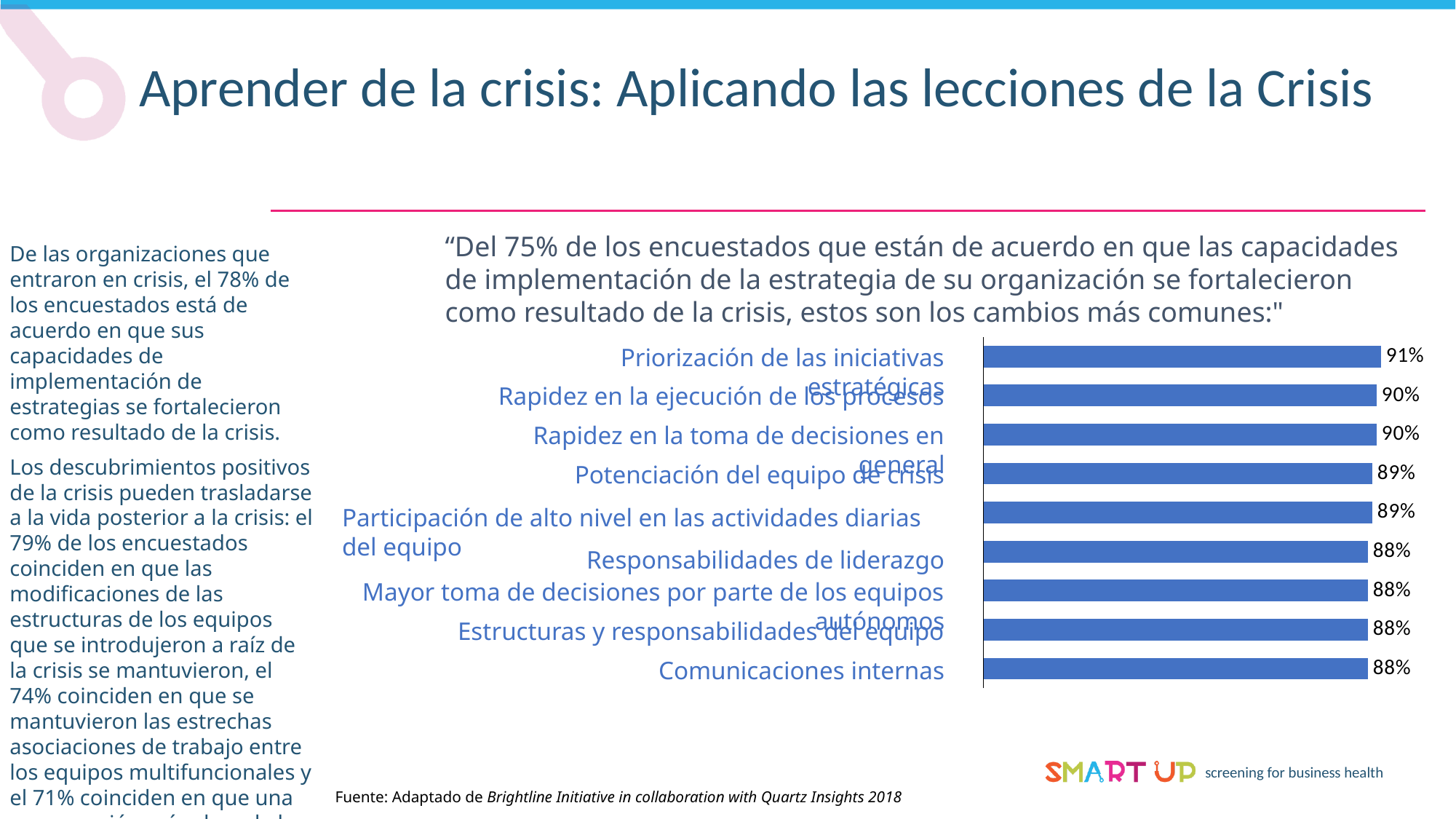
What is the difference between the value for "Priorización de las iniciativas estratégicas" and the value for "Estructuras y responsabilidades del equipo"? 3 percentage points What is the value for "Potenciación del equipo de crisis"? 89% What is the value for "Priorización de las iniciativas estratégicas"? 91% What type of chart is shown on the slide? Bar chart What is the value for "Comunicaciones internas"? 88% How many categories does the bar chart show? 9 Which is larger: the value for "Priorización de las iniciativas estratégicas" or the value for "Comunicaciones internas"? Priorización de las iniciativas estratégicas What is the value for "Responsabilidades de liderazgo"? 88% What is the value for "Rapidez en la ejecución de los procesos"? 90% What colour are the bars in the chart? Blue Which category has the highest value in the bar chart? Priorización de las iniciativas estratégicas What is the difference between the value for "Rapidez en la toma de decisiones en general" and the value for "Participación de alto nivel en las actividades diarias del equipo"? 1 percentage point